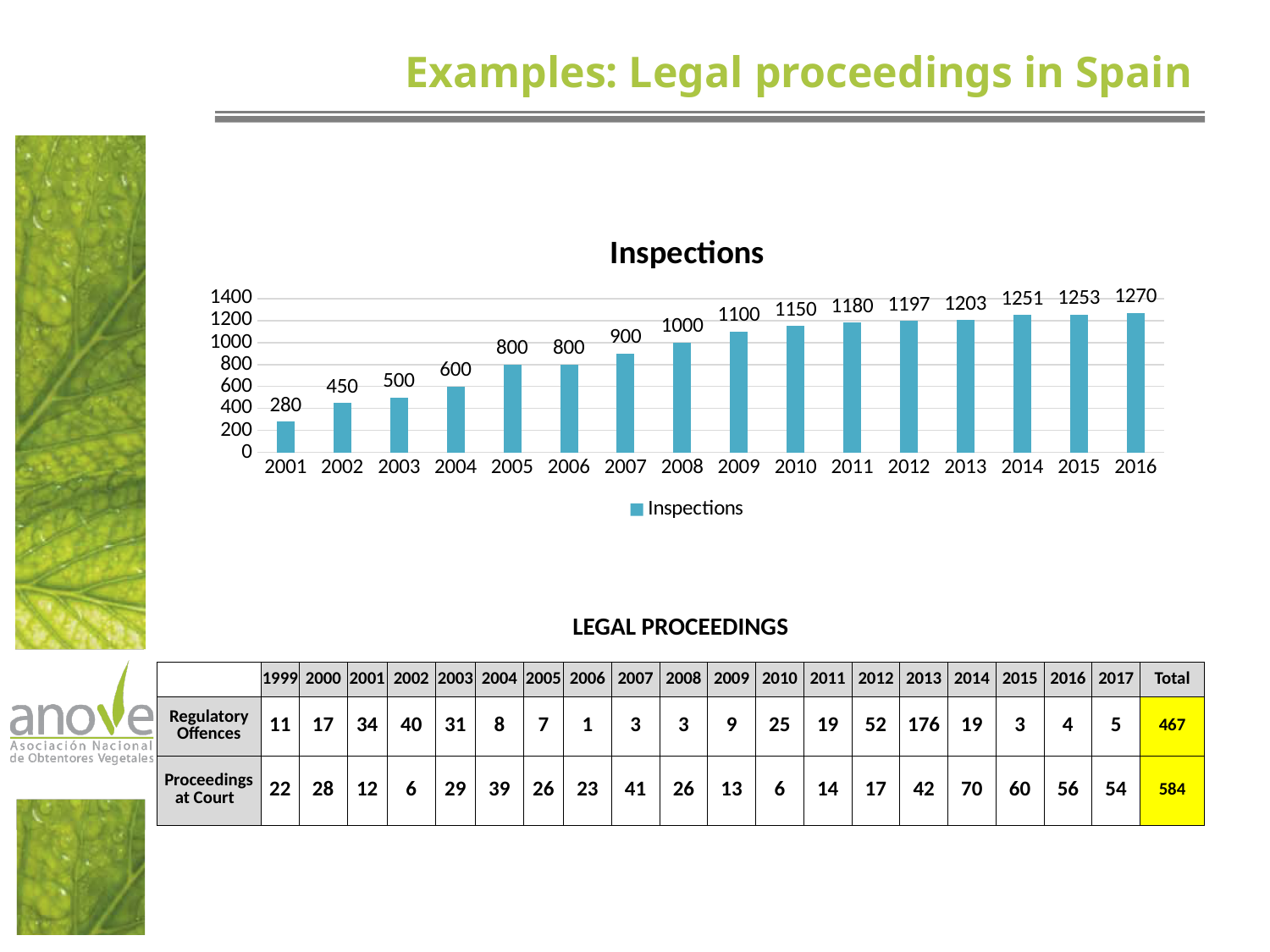
What kind of chart is the Inspections chart? bar chart What is the value for 2016 in the Inspections chart? 1270 Do the values in the Inspections chart generally rise or fall from 2001 to 2016? rise Which year has the highest value in the Inspections chart? 2016 In the Inspections chart, what is the difference between the values for 2016 and 2001? 990 Which year has the lowest value in the Inspections chart? 2001 In the Inspections chart, which is larger, the value for 2004 or the value for 2007? 2007 What is the value for 2001 in the Inspections chart? 280 How many series does the legend of the Inspections chart list? 1 What is the value for 2012 in the Inspections chart? 1197 In the Inspections chart, what is the difference between the values for 2010 and 2009? 50 How many years are shown on the x axis of the Inspections chart? 16